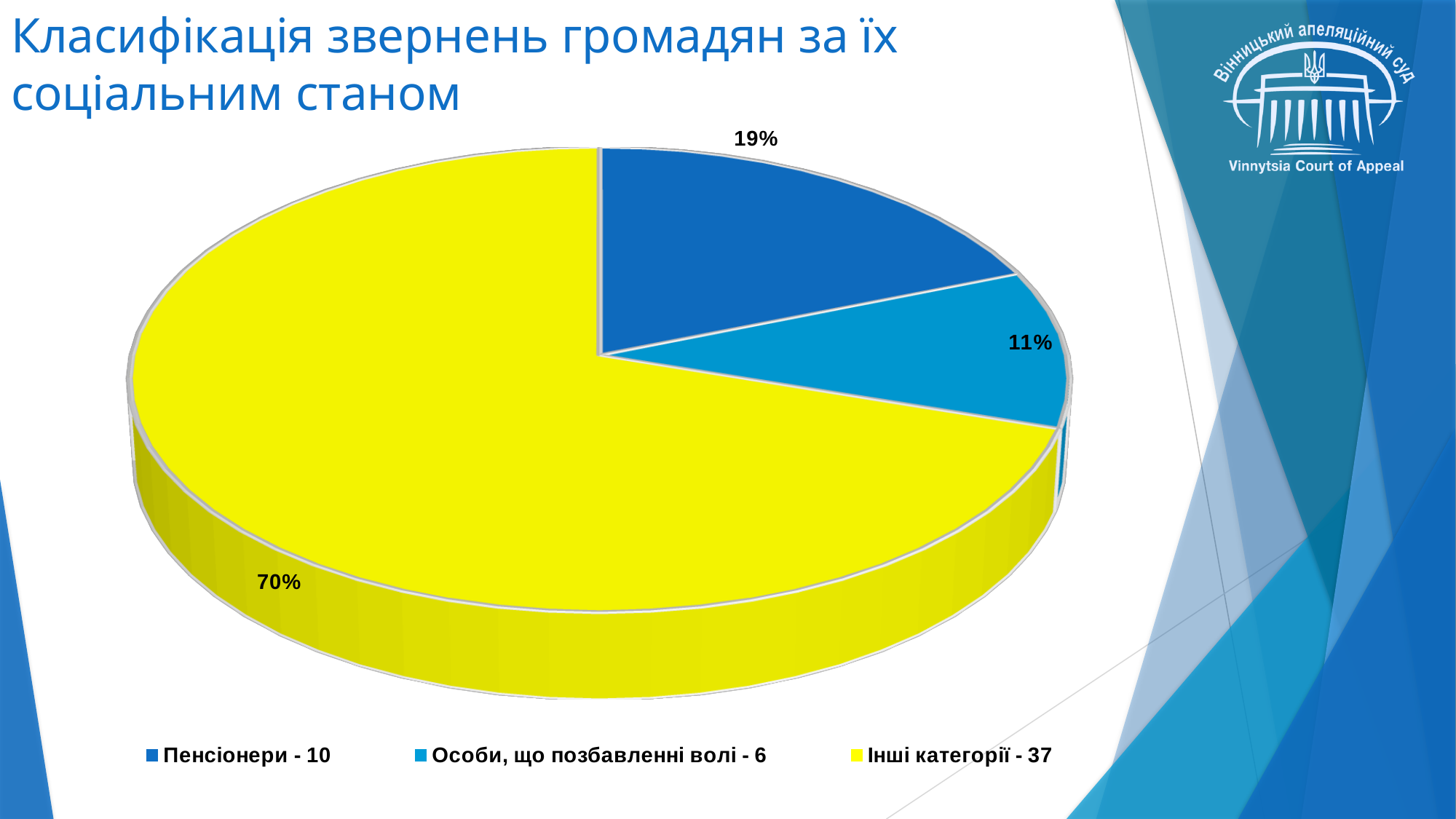
What is the title of the slide? Класифікація звернень громадян за їх соціальним станом How many categories are shown in the pie chart? 3 Which category has the smallest slice of the pie? Особи, що позбавленні волі - 6 What is the difference in percentage points between the Інші категорії slice and the Пенсіонери slice? 51% What kind of chart is shown on the slide? Pie chart What colour is the slice for Інші категорії - 37? Yellow What percentage share does the slice for Пенсіонери - 10 have? 19% What is the difference in percentage points between the Пенсіонери slice and the Особи, що позбавленні волі slice? 8% Which category has the largest slice of the pie? Інші категорії - 37 Which slice is larger: Пенсіонери or Особи, що позбавленні волі? Пенсіонери What percentage share does the slice for Інші категорії - 37 have? 70% What percentage share does the slice for Особи, що позбавленні волі - 6 have? 11%